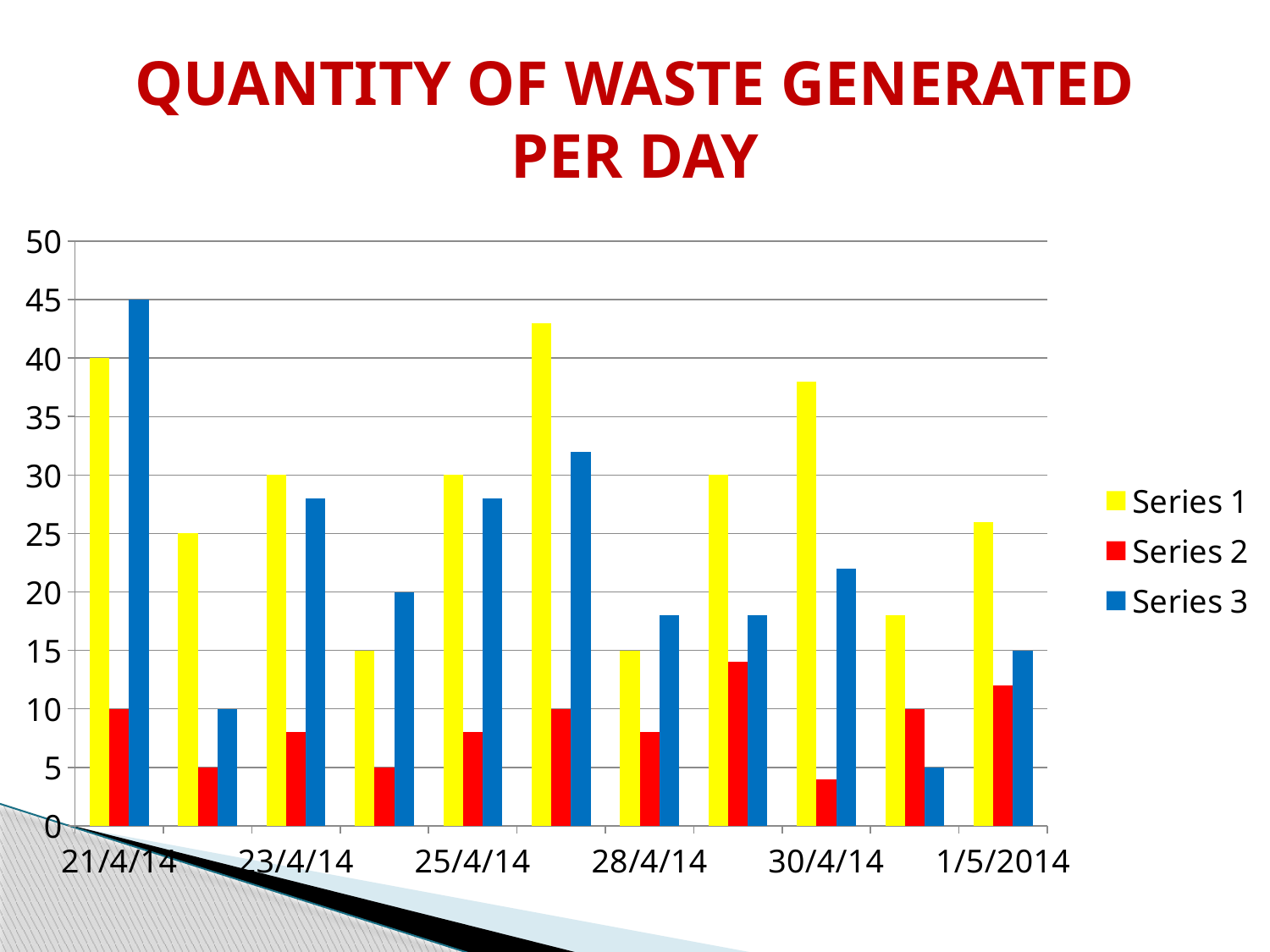
On which date does Series 3 reach its highest value? 21/4/14 How many groups of bars are plotted along the x axis? 11 On 30/4/14, which is larger: Series 1 or Series 3? Series 1 On 21/4/14, what is the difference between the Series 3 value and the Series 1 value? 5 What is the value of Series 1 on 28/4/14? 15 What is the value of Series 3 on 21/4/14? 45 Is the value for Series 1 on 30/4/14 greater or less than 35? greater Is the value for Series 3 on 23/4/14 greater or less than 30? less How many series does the legend list? 3 What is the title of the chart? QUANTITY OF WASTE GENERATED PER DAY What type of chart is shown on the slide? Bar chart What is the value of Series 1 on 21/4/14? 40